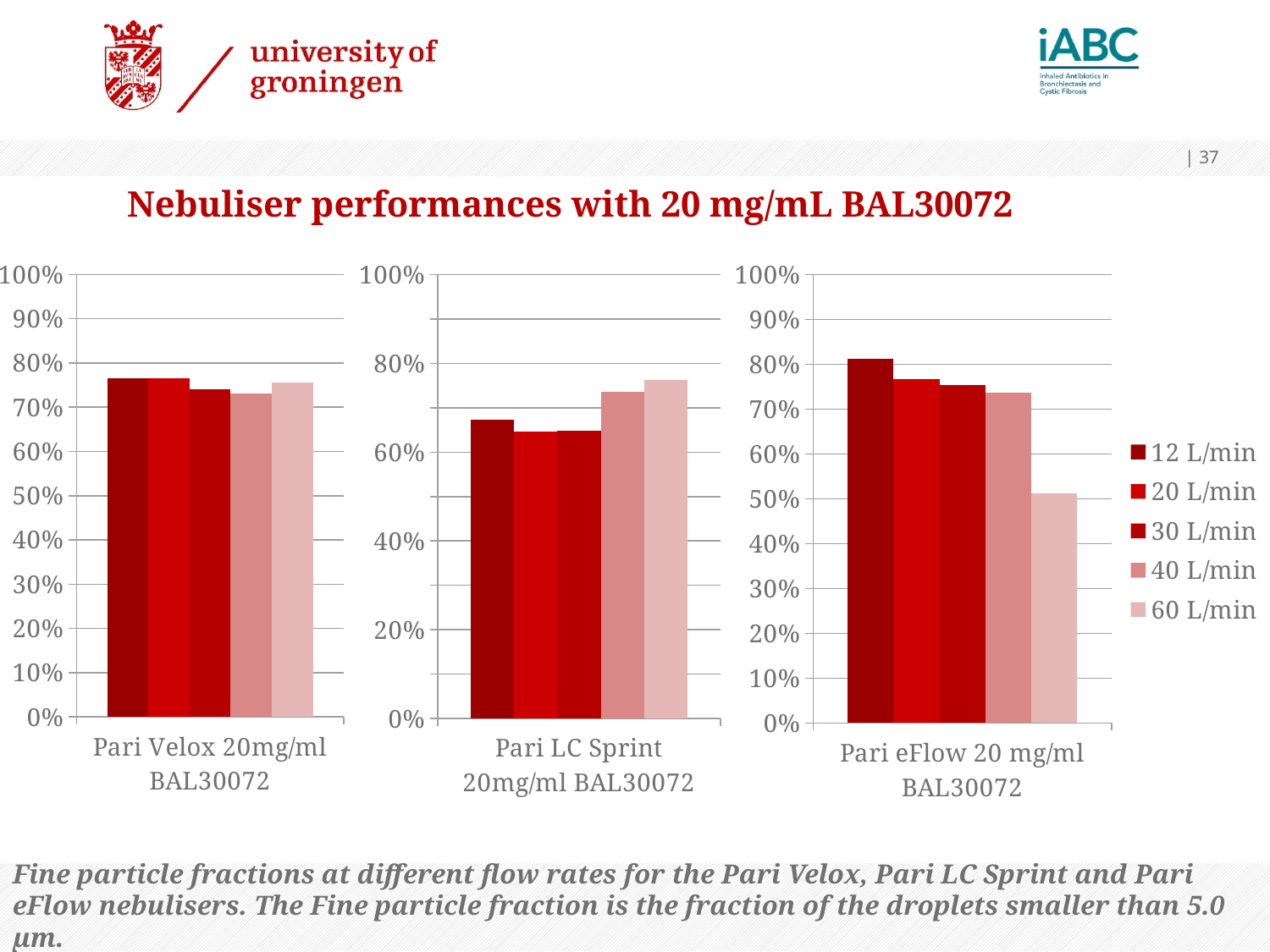
What kind of chart is the left chart, titled Pari Velox 20mg/ml BAL30072? Bar chart In the right chart (Pari eFlow 20 mg/ml BAL30072), do the values rise or fall as the flow rate increases from 12 L/min to 60 L/min? fall In the right chart (Pari eFlow 20 mg/ml BAL30072), which flow rate has the highest value? 12 L/min In the middle chart (Pari LC Sprint 20mg/ml BAL30072), which is larger, the value for 60 L/min or the value for 20 L/min? 60 L/min In the right chart (Pari eFlow 20 mg/ml BAL30072), is the value for 12 L/min greater or less than 80%? greater In the right chart (Pari eFlow 20 mg/ml BAL30072), is the value for 60 L/min greater or less than 60%? less In the middle chart (Pari LC Sprint 20mg/ml BAL30072), is the value for 12 L/min greater or less than 70%? less In the middle chart (Pari LC Sprint 20mg/ml BAL30072), which flow rate has the highest value? 60 L/min In the right chart (Pari eFlow 20 mg/ml BAL30072), which flow rate has the lowest value? 60 L/min How many series does the legend on the slide list? 5 What is the title of the slide above the three charts? Nebuliser performances with 20 mg/mL BAL30072